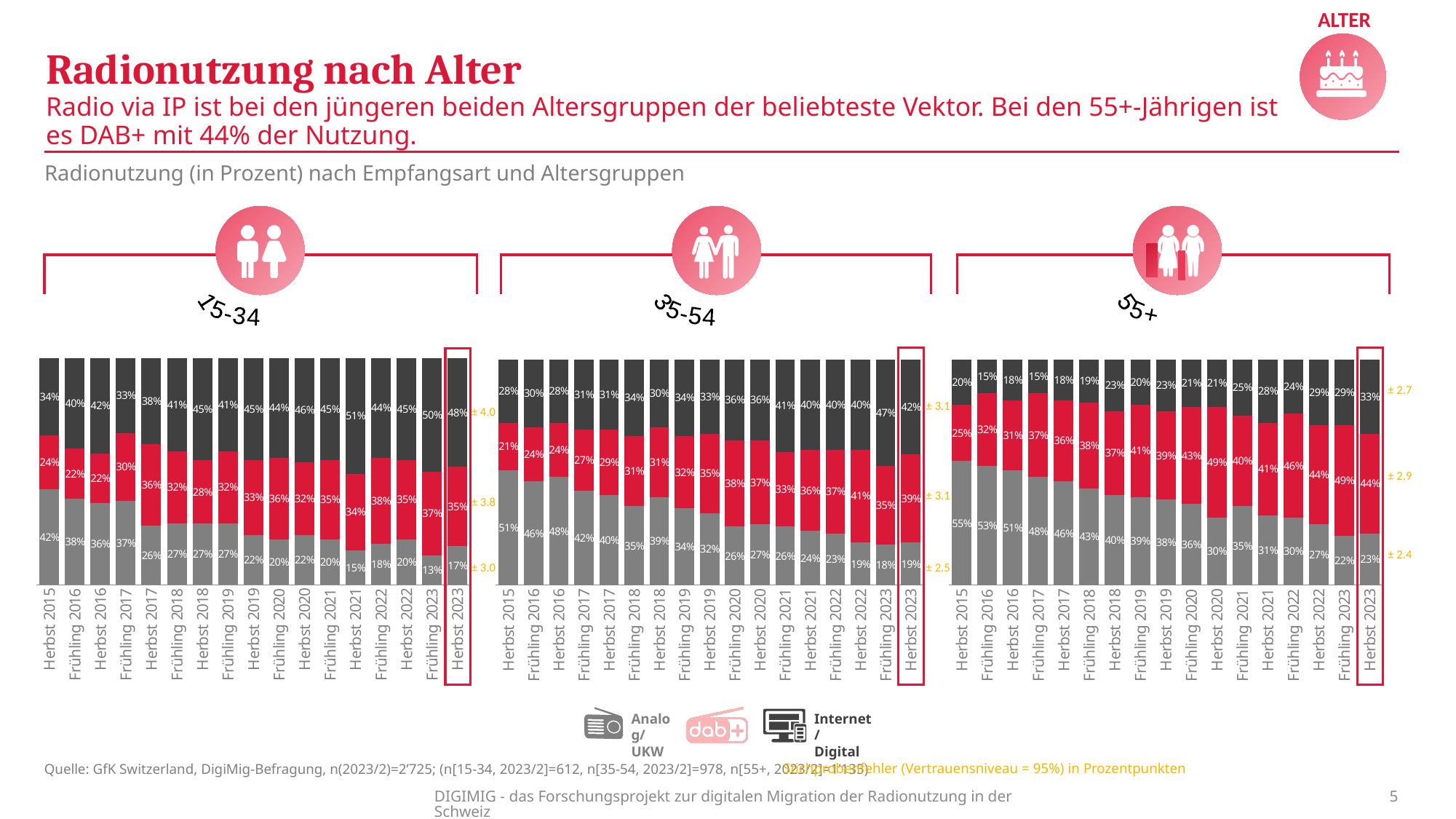
In the 55+ chart, which period has the highest Analog/UKW share? Herbst 2015 In the 15-34 chart, what is the Analog/UKW share for Frühling 2023? 13% In the 15-34 chart, which period has the lowest Analog/UKW share? Frühling 2023 In the 55+ chart, which is larger for Herbst 2023: the DAB+ share or the Internet/Digital share? DAB+ In the 35-54 chart, what is the difference between the Internet/Digital share in Herbst 2023 and in Herbst 2015? 14 percentage points In the 55+ chart, does the Analog/UKW share rise or fall from Herbst 2015 to Herbst 2023? Fall In the 15-34 chart, what is the Internet/Digital share for Herbst 2021? 51% What kind of chart is used for the 15-34 age group? Stacked bar chart In the 35-54 chart, what is the Analog/UKW share for Herbst 2015? 51% How many periods (bars) are shown in the 35-54 chart? 17 How many series does the legend list? 3 In the 55+ chart, what is the DAB+ share for Herbst 2023? 44%